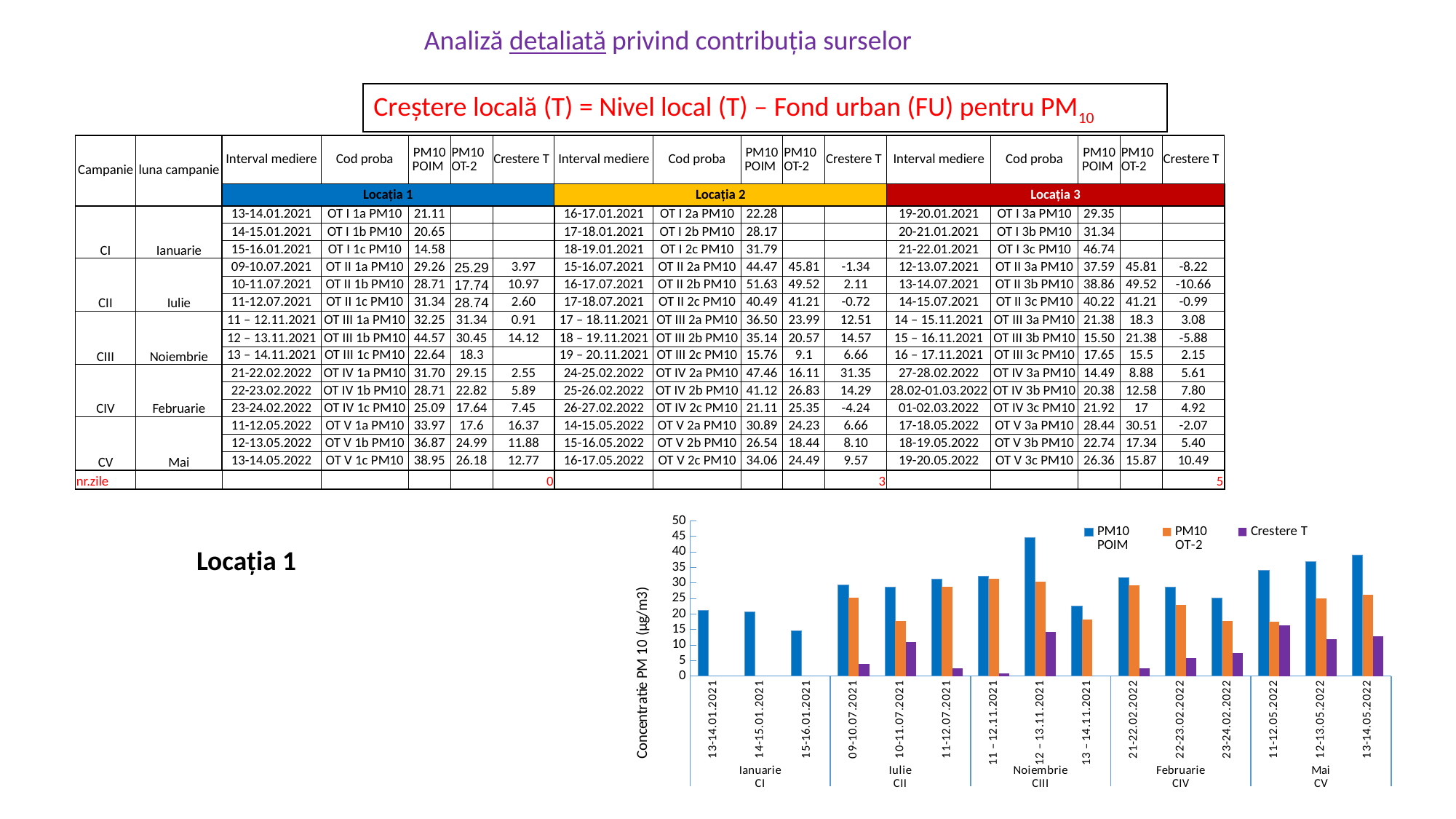
How many series does the chart legend list? 3 Which campaign group in the chart has no PM10 OT-2 or Crestere T bars? Ianuarie CI Is the PM10 POIM value for 15-16.01.2021 greater or less than 20? less Do the PM10 POIM bars rise or fall across the three dates of the Mai (CV) campaign? rise Is the PM10 POIM value for 12 – 13.11.2021 greater or less than 40? greater Which date has the highest PM10 POIM bar in the chart? 12 – 13.11.2021 Do the PM10 POIM bars rise or fall across the three dates of the Ianuarie (CI) campaign? fall Which date has the lowest PM10 POIM bar in the chart? 15-16.01.2021 What kind of chart is shown on the slide? bar chart How many date categories are plotted along the x axis of the chart? 15 What is the label of the chart's vertical axis? Concentratie PM 10 (µg/m3) For 12 – 13.11.2021, which is larger: PM10 POIM or PM10 OT-2? PM10 POIM